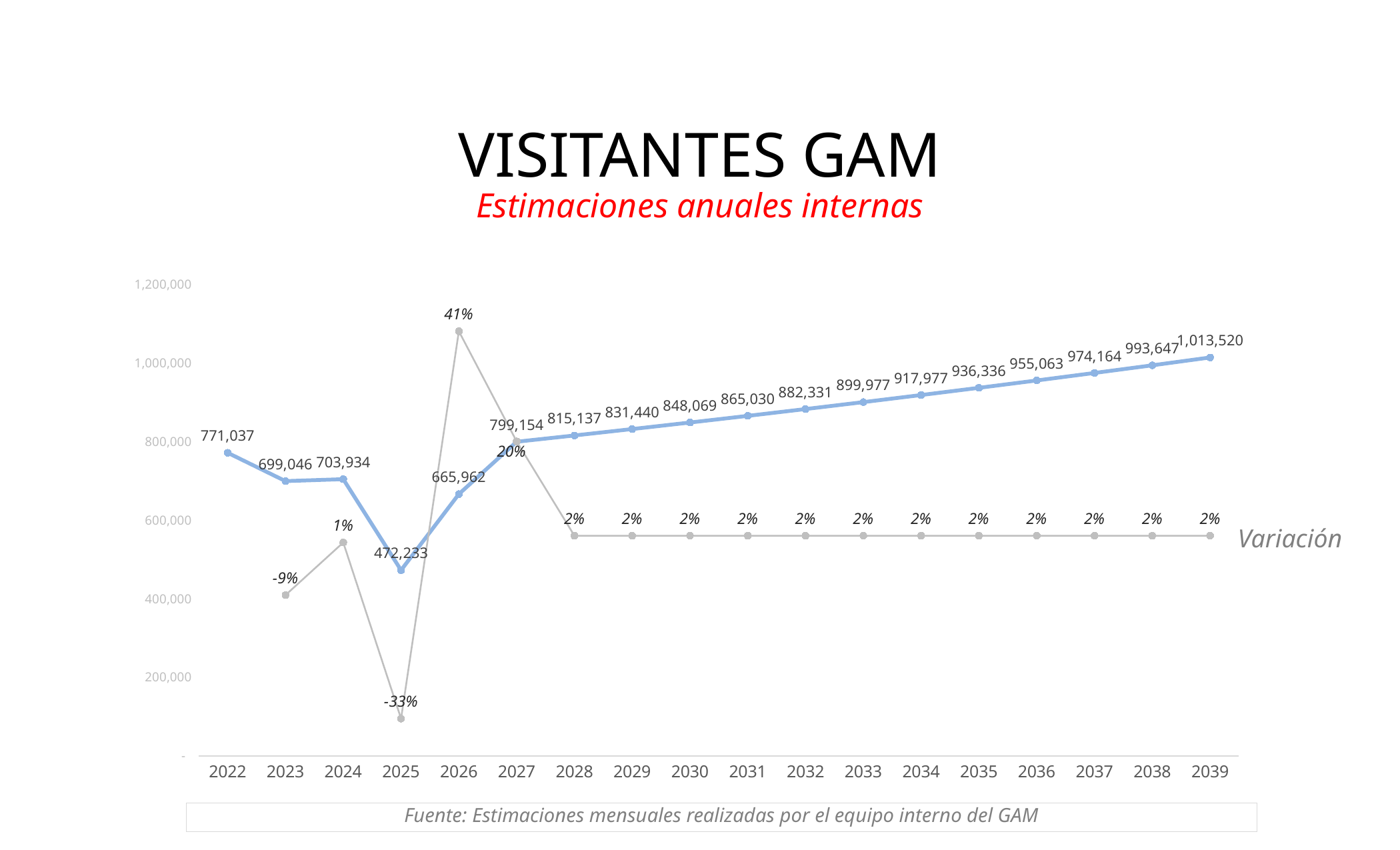
What is the difference between the visitor estimates for 2022 and 2025? 298,804 What is the estimated number of visitors for 2039? 1,013,520 What is the Variación value for 2026? 41% How many years are shown on the x axis? 18 What is the Variación value for 2025? -33% Do the visitor estimates rise or fall from 2027 to 2039? Rise Which year has the highest estimated number of visitors? 2039 What is the title of the chart? VISITANTES GAM Which year has more estimated visitors, 2023 or 2024? 2024 What type of chart is shown on the slide? Line chart Which year has the lowest estimated number of visitors? 2025 What is the estimated number of visitors for 2025? 472,233